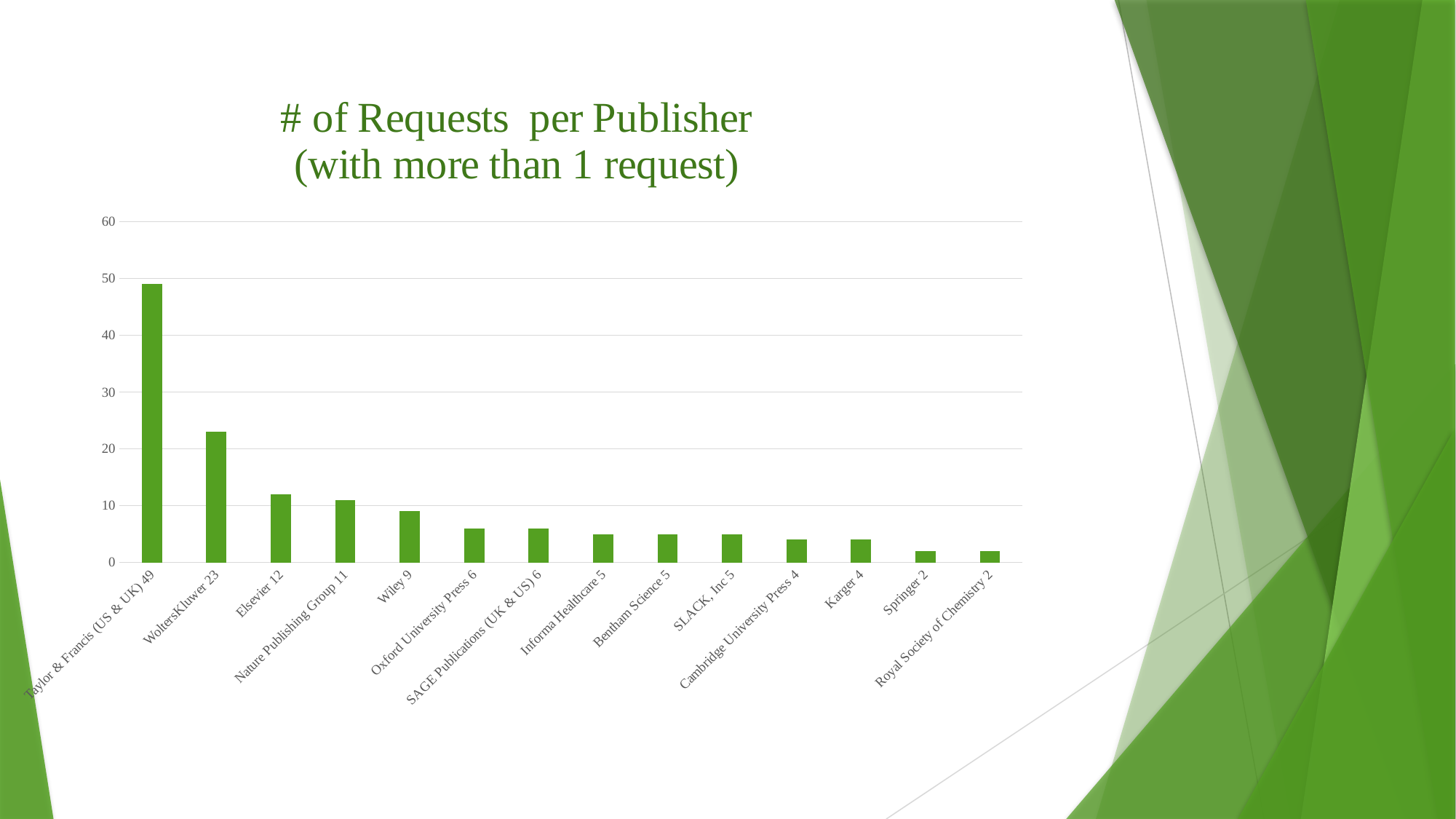
What kind of chart is shown on the slide? Bar chart Which publisher has the highest number of requests? Taylor & Francis (US & UK) How many requests does Nature Publishing Group have? 11 How many publishers are shown in the chart? 14 Is the value for Taylor & Francis (US & UK) greater or less than 40? greater What is the difference in requests between Taylor & Francis (US & UK) and WoltersKluwer? 26 How many requests does Elsevier have? 12 Do the values generally rise or fall from left to right along the x axis? Fall How many requests does Karger have? 4 Which has more requests, Wiley or Oxford University Press? Wiley How many requests does WoltersKluwer have? 23 What is the title of the chart? # of Requests per Publisher (with more than 1 request)